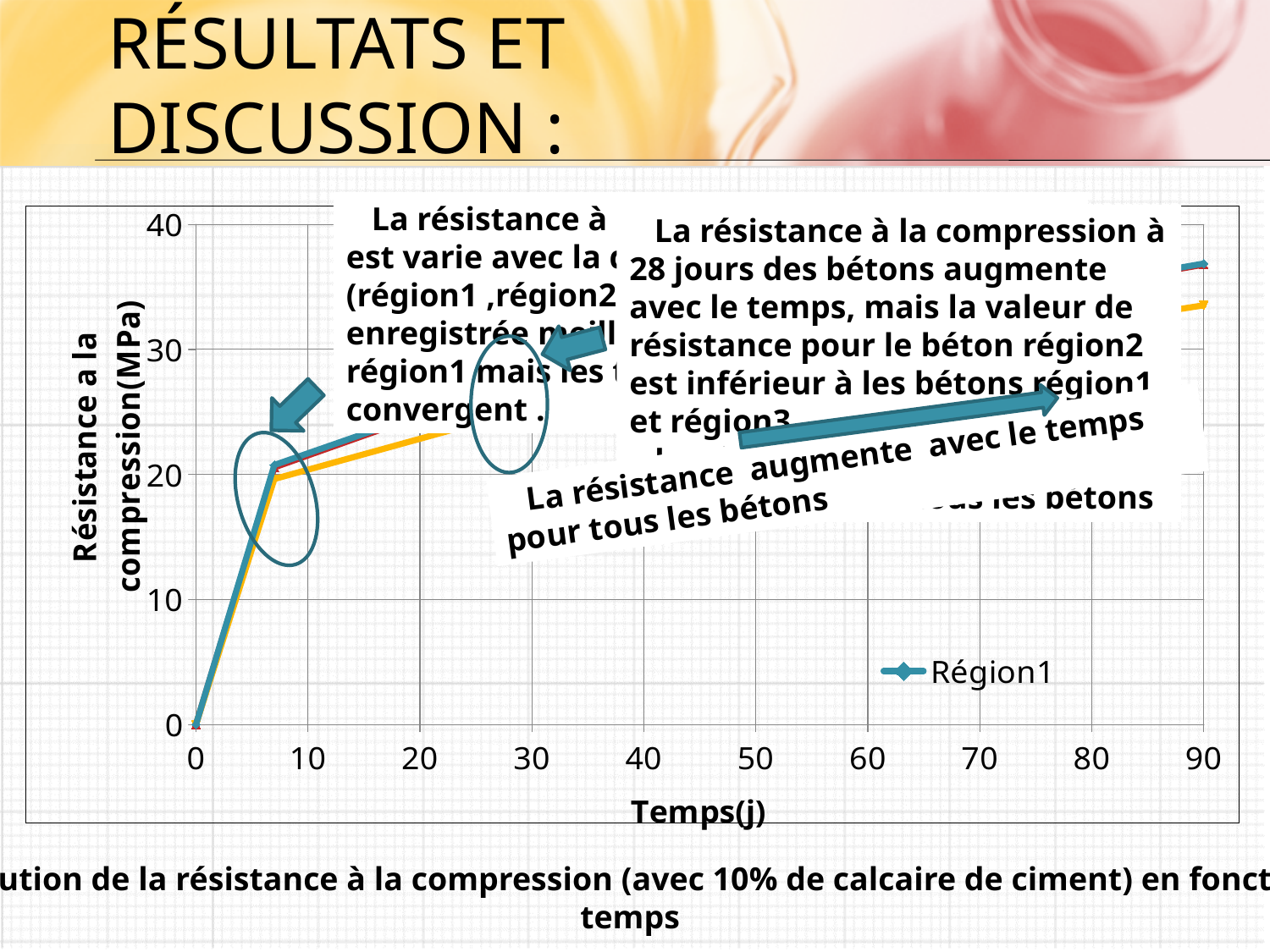
Is the value for Région1 at 90 days greater or less than 30? greater Is the value of the yellow line at 90 days greater or less than 40? less At 90 days, which line is higher: the teal Région1 line or the yellow line? the teal Région1 line Do the plotted values rise or fall as time increases along the x axis? rise Is the value for Région1 at 10 days greater or less than 10? greater What kind of chart is shown on the slide? line chart What is the value for Région1 at time 0? 0 What is the title of the y axis of the chart? Résistance a la compression(MPa) What is the title of the x axis of the chart? Temps(j)